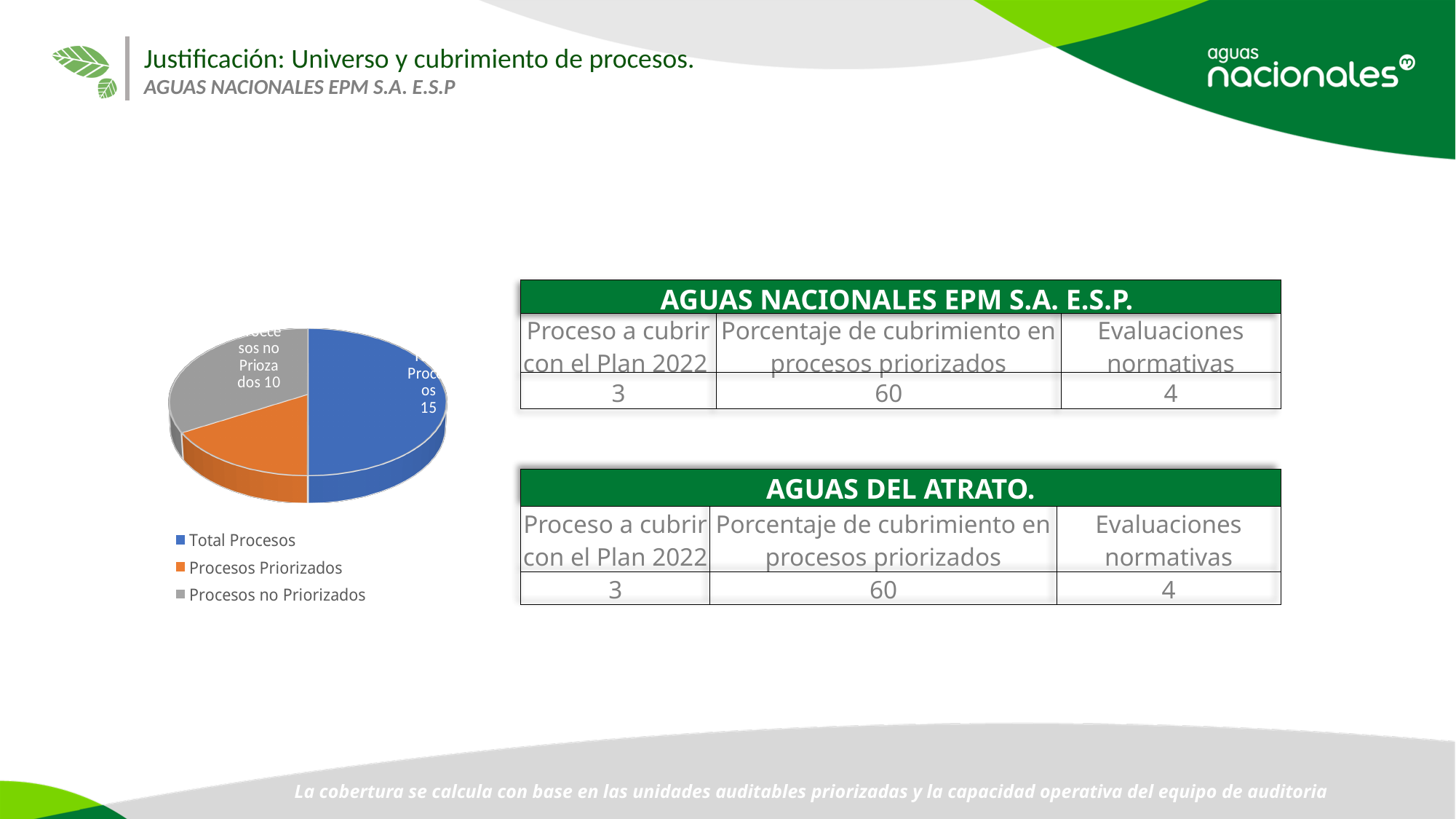
What value is shown for Procesos no Priorizados in the pie chart? 10 How many slices does the pie chart have? 3 Which is larger in the pie chart, Total Procesos or Procesos no Priorizados? Total Procesos What is the difference between the Total Procesos value and the Procesos no Priorizados value in the pie chart? 5 Which slice of the pie chart is the smallest? Procesos Priorizados What value is shown for Total Procesos in the pie chart? 15 How many entries does the legend of the pie chart list? 3 Which is larger in the pie chart, Procesos no Priorizados or Procesos Priorizados? Procesos no Priorizados What kind of chart is shown on the slide? Pie chart What colour represents Procesos Priorizados in the pie chart? Orange What colour represents Total Procesos in the pie chart? Blue Which slice of the pie chart is the largest? Total Procesos